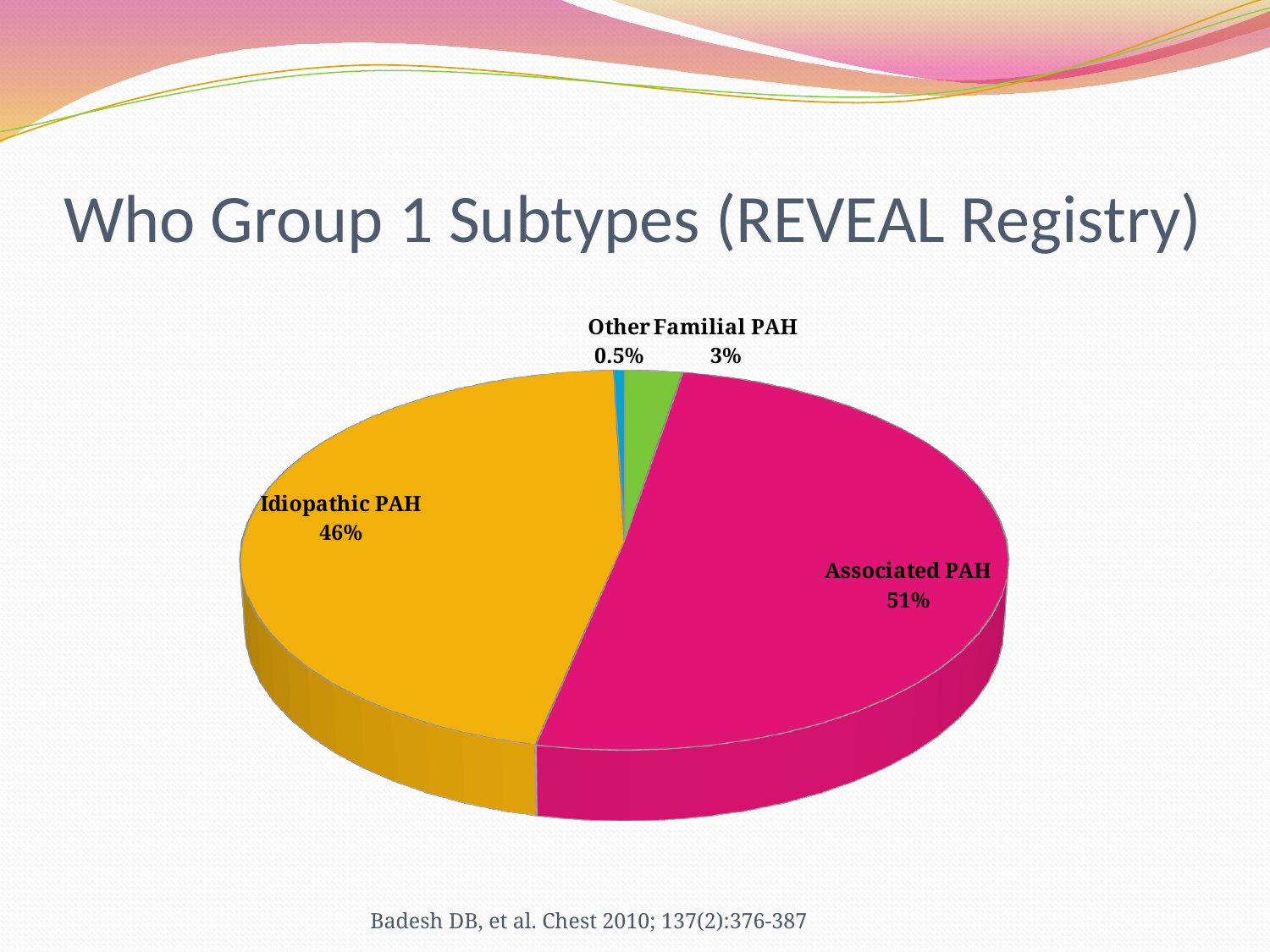
What share of the pie does Associated PAH represent? 51% What kind of chart is shown on the slide? Pie chart Which subtype has the smallest slice of the pie? Other What is the value shown for Familial PAH? 3% What is the value shown for Other? 0.5% What is the difference between the Familial PAH and Other shares? 2.5% How many slices does the pie chart have? 4 Which is larger, the share for Familial PAH or the share for Other? Familial PAH What share of the pie does Idiopathic PAH represent? 46% Which subtype has the largest slice of the pie? Associated PAH What is the difference between the Associated PAH and Idiopathic PAH shares? 5% What colour is the Idiopathic PAH slice? Orange/yellow